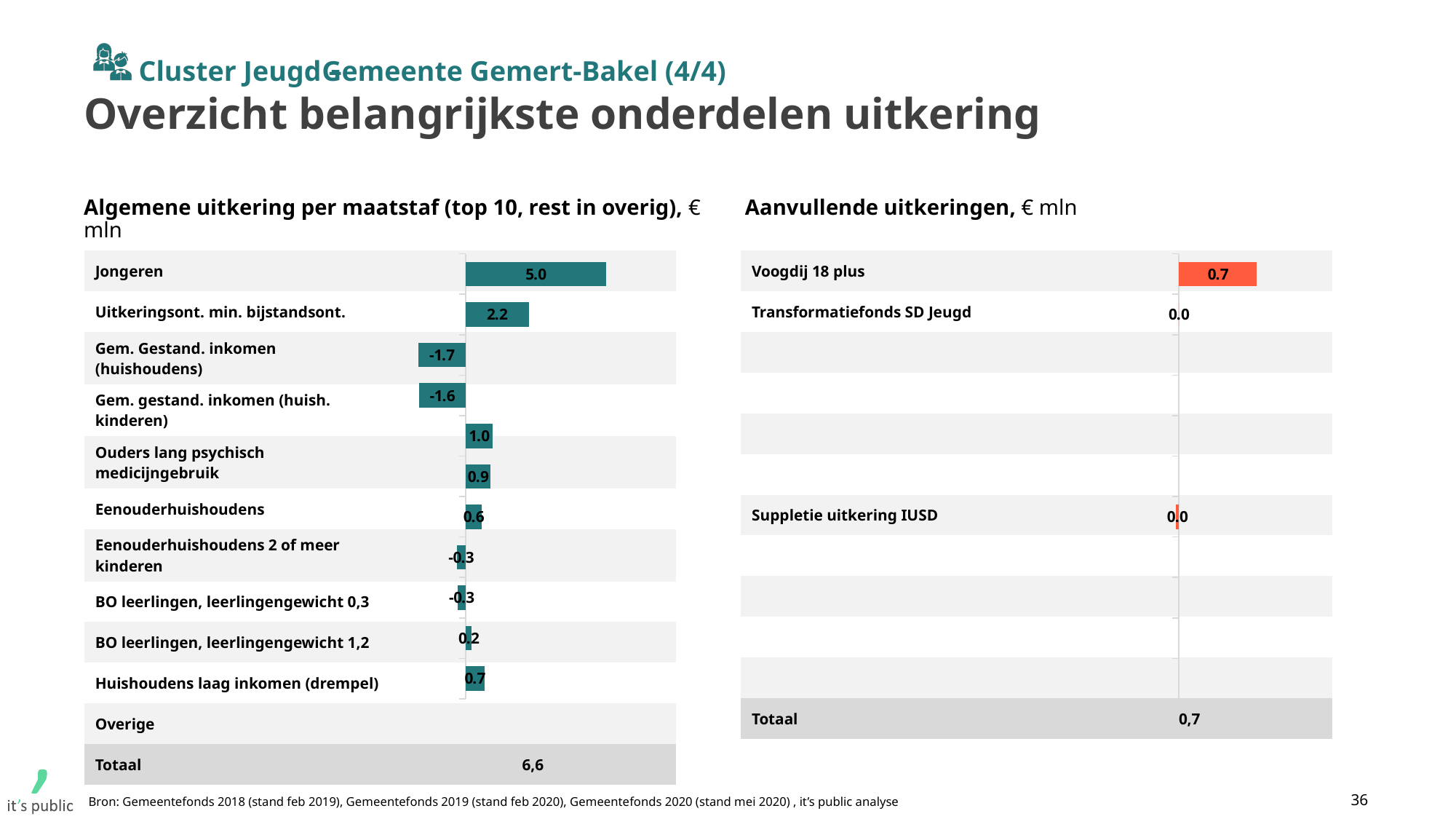
In the chart 'Algemene uitkering per maatstaf', which category has the lowest value? Gem. Gestand. inkomen (huishoudens) In the chart 'Aanvullende uitkeringen', what is the value for Voogdij 18 plus? 0.7 What kind of chart is the 'Aanvullende uitkeringen' chart on the right? Bar chart In the chart 'Aanvullende uitkeringen', what colour is the bar for Voogdij 18 plus? Orange In the chart 'Algemene uitkering per maatstaf', what is the value for Gem. Gestand. inkomen (huishoudens)? -1.7 In the chart 'Algemene uitkering per maatstaf', what is the value for Jongeren? 5.0 In the chart 'Aanvullende uitkeringen', what is the Totaal shown? 0,7 In the chart 'Algemene uitkering per maatstaf', which is larger: Jongeren or Uitkeringsont. min. bijstandsont.? Jongeren In the chart 'Algemene uitkering per maatstaf', which category has the highest value? Jongeren In the chart 'Algemene uitkering per maatstaf', what is the difference between the values for Jongeren and Uitkeringsont. min. bijstandsont.? 2.8 In the chart 'Algemene uitkering per maatstaf', what is the value for Uitkeringsont. min. bijstandsont.? 2.2 In the chart 'Algemene uitkering per maatstaf', what is the Totaal shown? 6,6